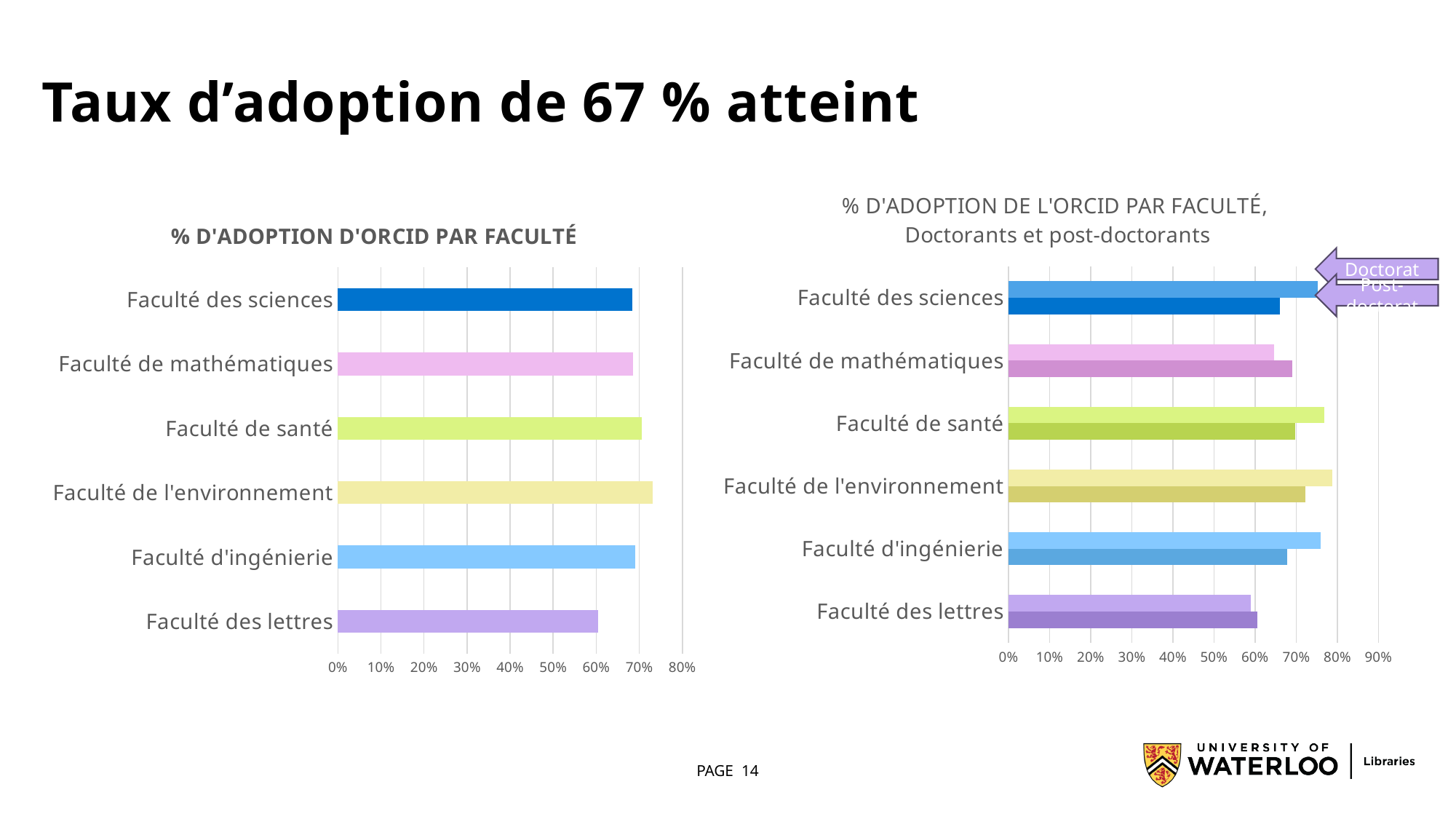
In the left chart '% D'ADOPTION D'ORCID PAR FACULTÉ', which is larger: the value for Faculté de santé or the value for Faculté des lettres? Faculté de santé What kind of chart is the left chart titled '% D'ADOPTION D'ORCID PAR FACULTÉ'? Bar chart In the left chart '% D'ADOPTION D'ORCID PAR FACULTÉ', is the value for Faculté des lettres greater or less than 70%? less In the left chart '% D'ADOPTION D'ORCID PAR FACULTÉ', which faculty has the lowest adoption rate? Faculté des lettres What is the highest tick value on the x axis of the right chart 'Doctorants et post-doctorants'? 90% In the right chart 'Doctorants et post-doctorants', which faculty has the lowest Doctorat value? Faculté des lettres How many series does the right chart 'Doctorants et post-doctorants' show per faculty? 2 In the left chart '% D'ADOPTION D'ORCID PAR FACULTÉ', which faculty has the highest adoption rate? Faculté de l'environnement In the right chart 'Doctorants et post-doctorants', is the Doctorat value for Faculté de l'environnement greater or less than 70%? greater How many faculties are shown in the left chart '% D'ADOPTION D'ORCID PAR FACULTÉ'? 6 In the left chart '% D'ADOPTION D'ORCID PAR FACULTÉ', is the value for Faculté de l'environnement greater or less than 70%? greater